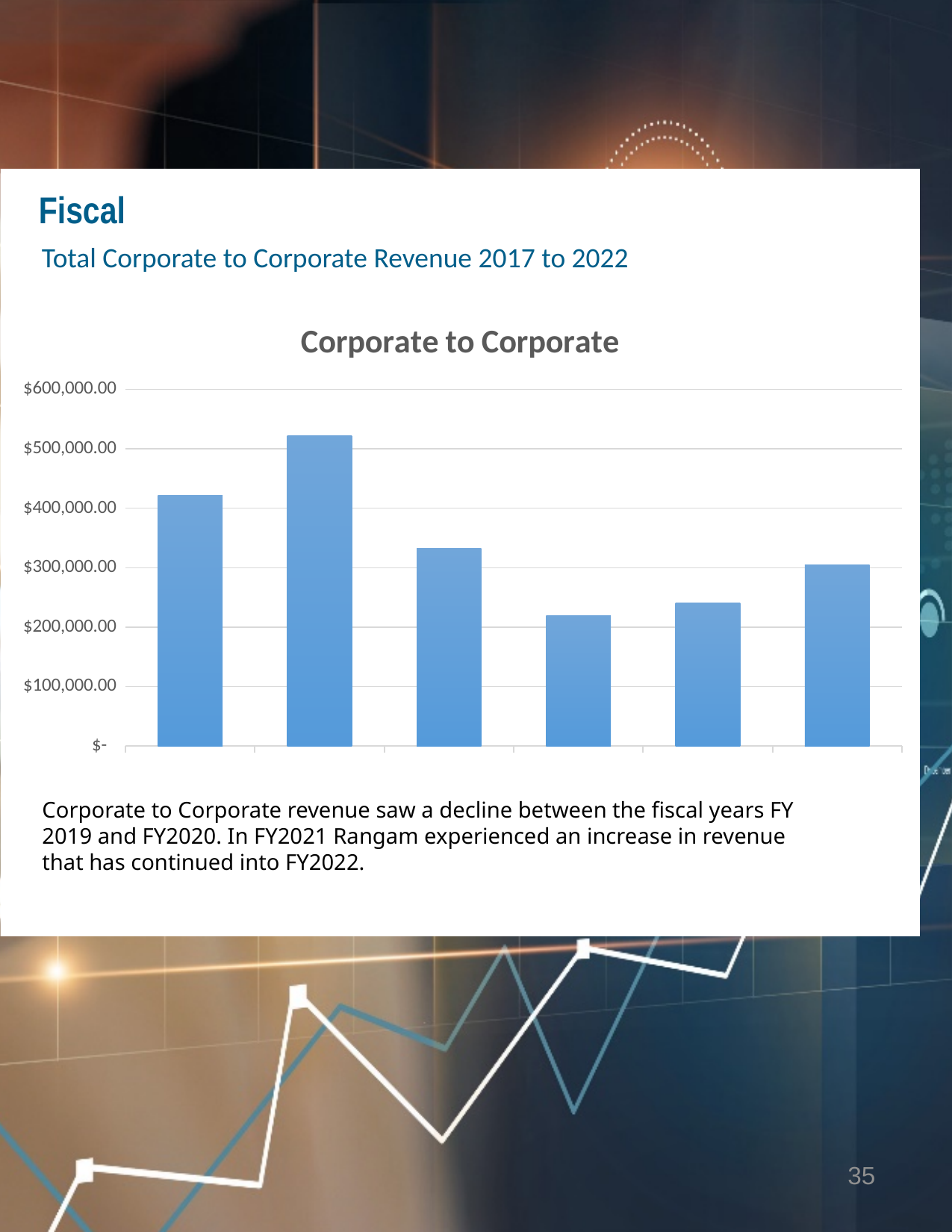
Is the value of the second bar from the left greater or less than $500,000.00? greater How many bars are plotted in the chart? 6 Which is larger, the first bar from the left or the third bar from the left? the first bar Which bar, counting from the left, is the tallest? the second bar Which bar, counting from the left, is the shortest? the fourth bar Is the value of the fourth bar from the left greater or less than $300,000.00? less What is the title of the chart? Corporate to Corporate What is the highest value shown on the y axis? $600,000.00 Is the value of the sixth bar from the left greater or less than $200,000.00? greater Do the values rise or fall from the fourth bar to the sixth bar? rise What kind of chart is shown on the slide? bar chart